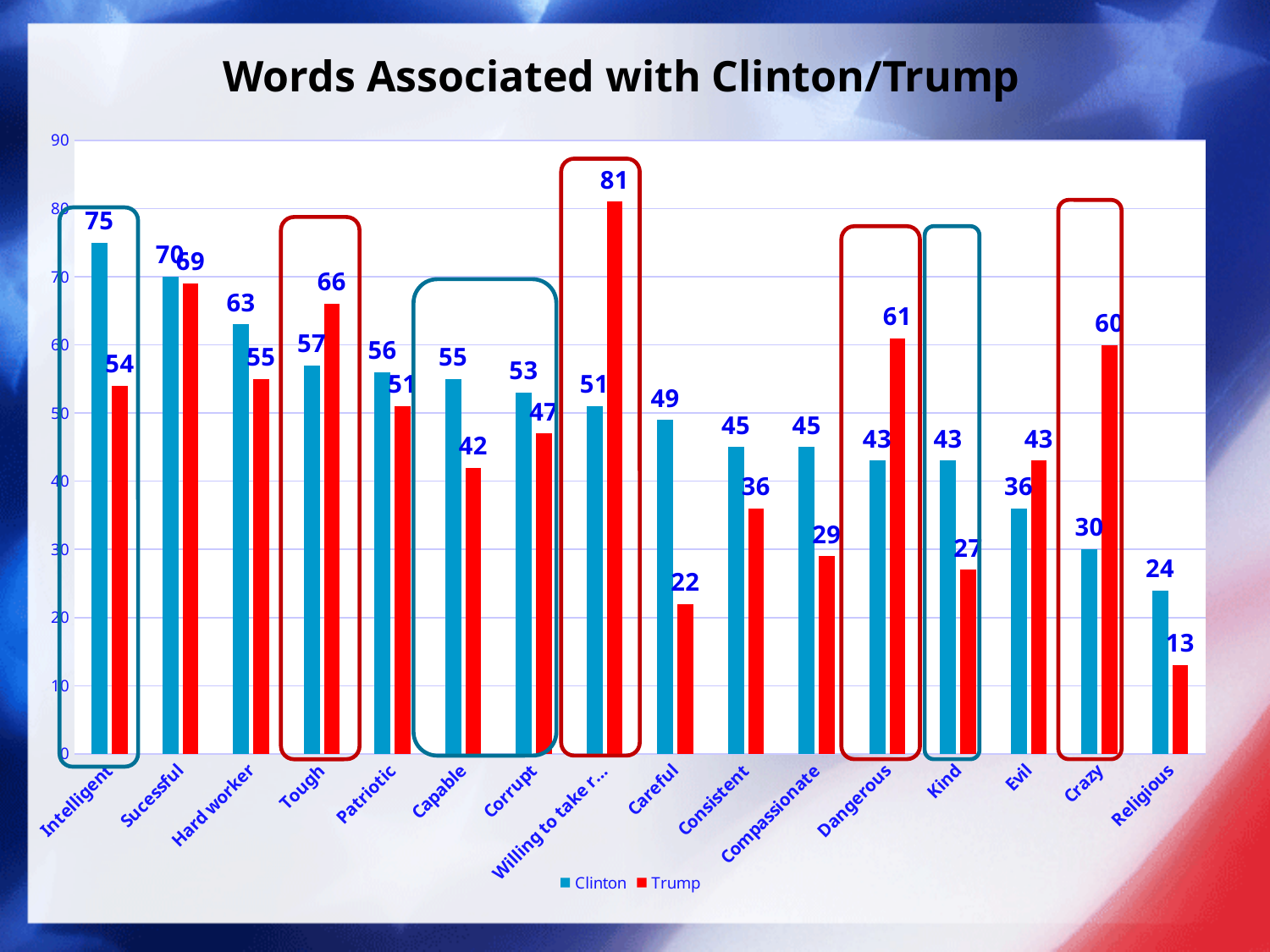
Which category has the highest value for Clinton? Intelligent In the Dangerous category, which series has the larger value, Clinton or Trump? Trump How many categories are shown on the x axis? 16 What is the value for Trump in the Crazy category? 60 In the Capable category, how much higher is the Clinton value than the Trump value? 13 What kind of chart is shown on the slide? Bar chart How many series does the legend list? 2 What is the value for Trump in the Kind category? 27 In the Careful category, what is the difference between the Clinton value and the Trump value? 27 Which category has the lowest value for Trump? Religious Which category has the lowest value for Clinton? Religious What is the value for Clinton in the Intelligent category? 75